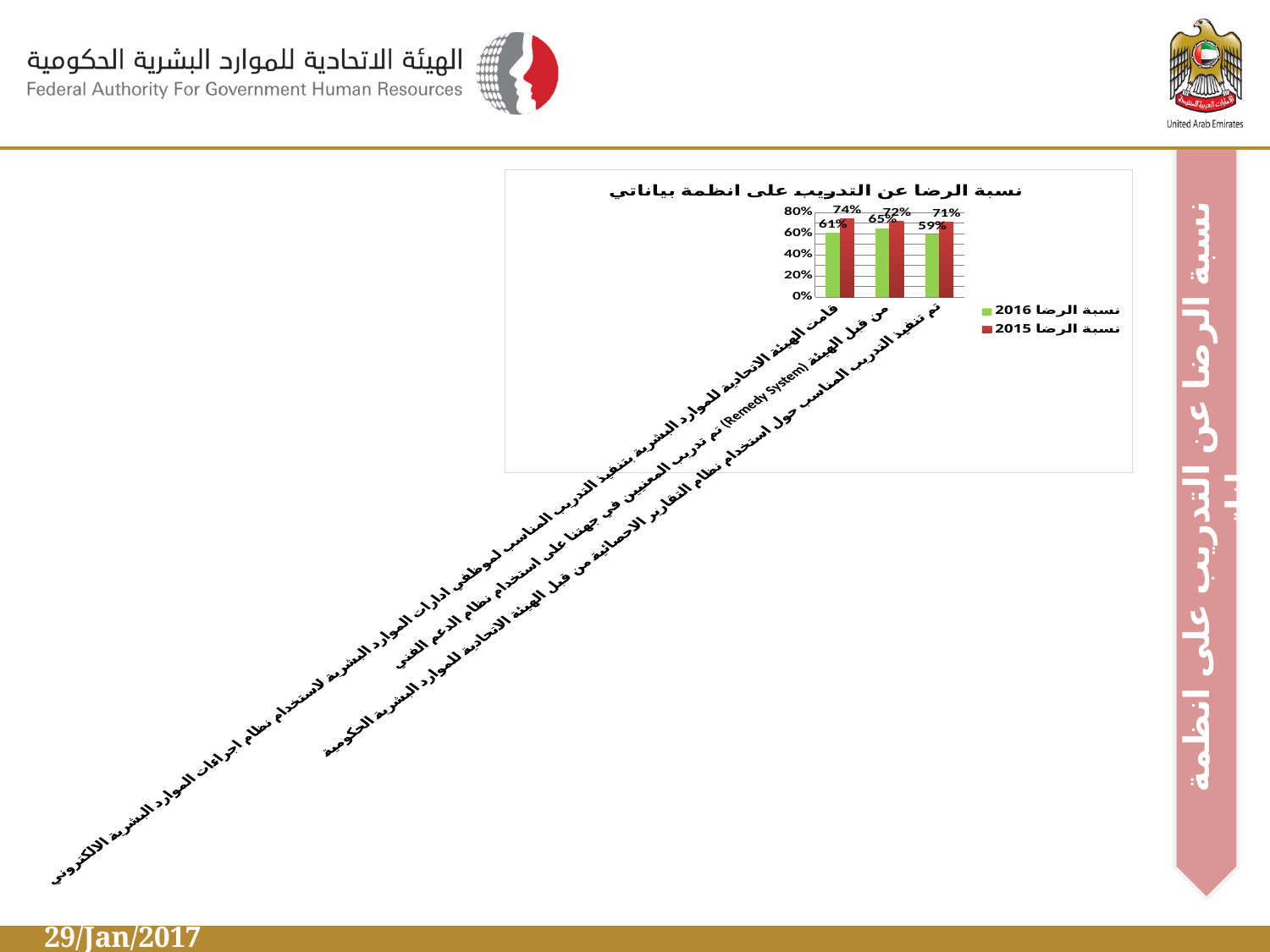
What is the value of the نسبة الرضا 2016 bar in the leftmost category group? 61% What is the value of the نسبة الرضا 2015 bar in the leftmost category group? 74% How many series does the chart legend list? 2 What type of chart is shown on the slide? bar chart What is the value of the نسبة الرضا 2015 bar in the rightmost category group? 71% What colour are the bars for the نسبة الرضا 2015 series? red Which category group has the highest نسبة الرضا 2016 value? the middle group (65%) Which category group has the lowest نسبة الرضا 2016 value? the rightmost group (59%) How many category groups of bars are plotted in the chart? 3 In the rightmost category group, which is larger: the نسبة الرضا 2015 value or the نسبة الرضا 2016 value? نسبة الرضا 2015 What is the difference between the نسبة الرضا 2015 and نسبة الرضا 2016 values in the leftmost category group? 13% What is the value of the نسبة الرضا 2016 bar in the middle category group? 65%